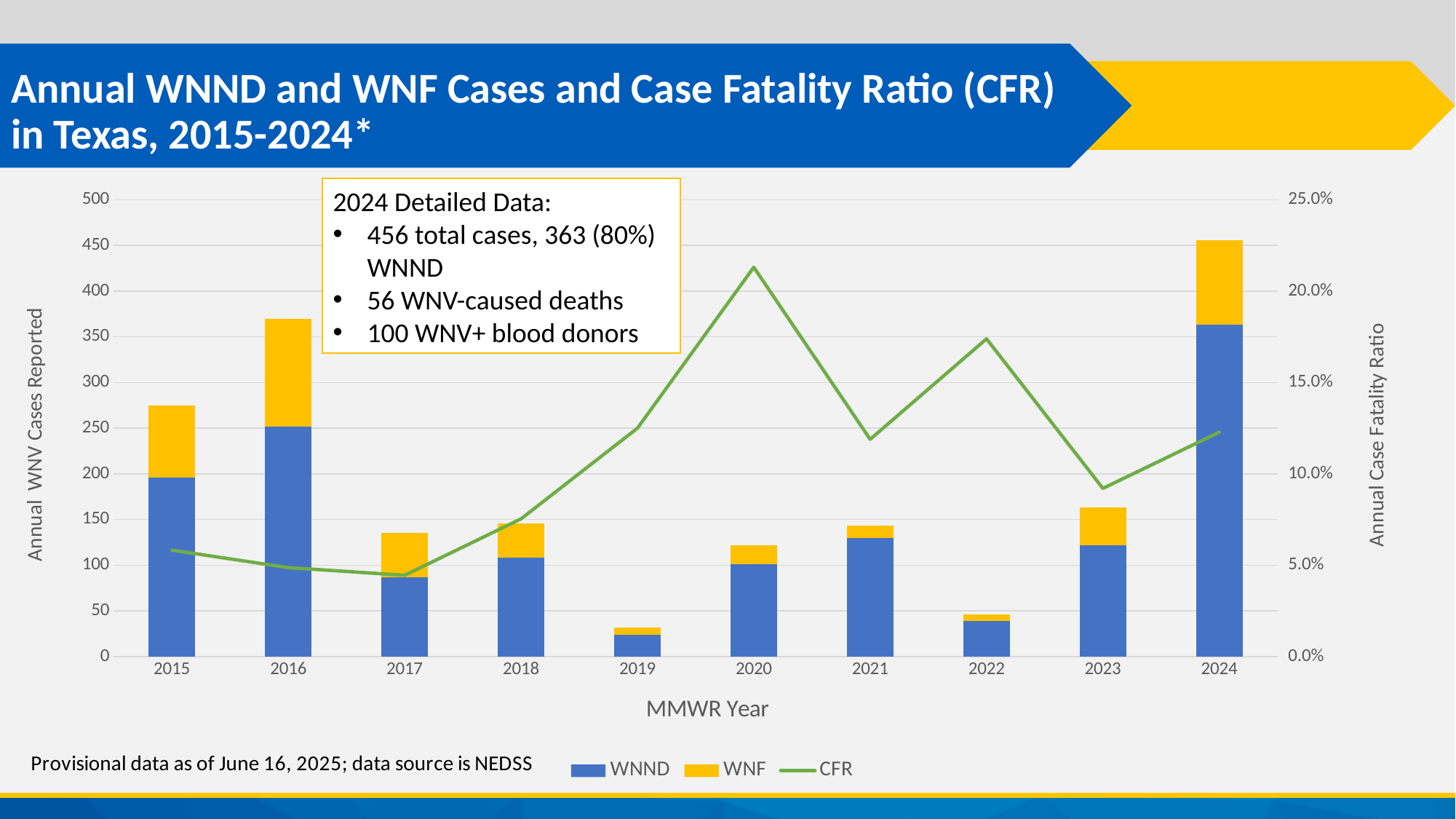
Which year has the highest total number of WNV cases reported? 2024 According to the slide, how many total cases were reported in 2024? 456 Which year has the lowest total number of WNV cases reported? 2019 Which year had more total WNV cases reported, 2015 or 2016? 2016 According to the slide, how many WNND cases were reported in 2024? 363 How many series does the chart legend list? 3 Is the CFR for 2023 greater or less than 10.0%? less What kind of chart is shown on the slide? A bar chart with a line Is the total number of cases in 2016 greater or less than 350? greater Which year has the highest Case Fatality Ratio (CFR)? 2020 Does the CFR line rise or fall from 2017 to 2020? Rises How many years are shown on the x axis of the chart? 10